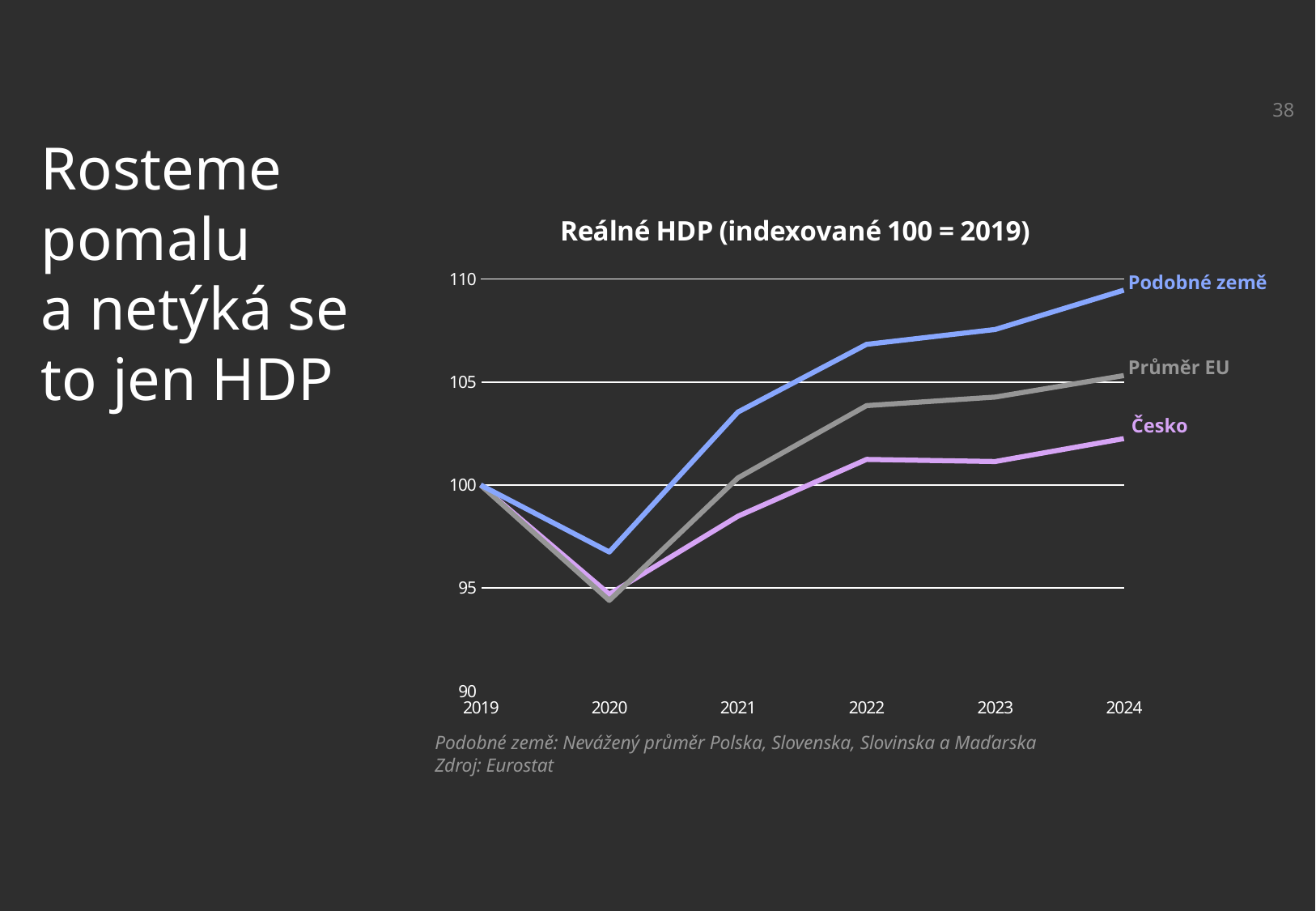
How many series are plotted in the chart? 3 Which series has the highest value in 2024? Podobné země Which series has the lowest value in 2024? Česko Is the value for Podobné země in 2024 greater or less than 105? greater What kind of chart is shown on the slide? line chart What is the title of the chart? Reálné HDP (indexované 100 = 2019) In 2021, which is larger: the value for Podobné země or the value for Česko? Podobné země Is the value for Podobné země in 2020 greater or less than 95? greater In which year does the Česko line reach its lowest value? 2020 What is the value for Česko in 2019? 100 Is the value for Česko in 2020 greater or less than 100? less How many years are shown on the x axis of the chart? 6